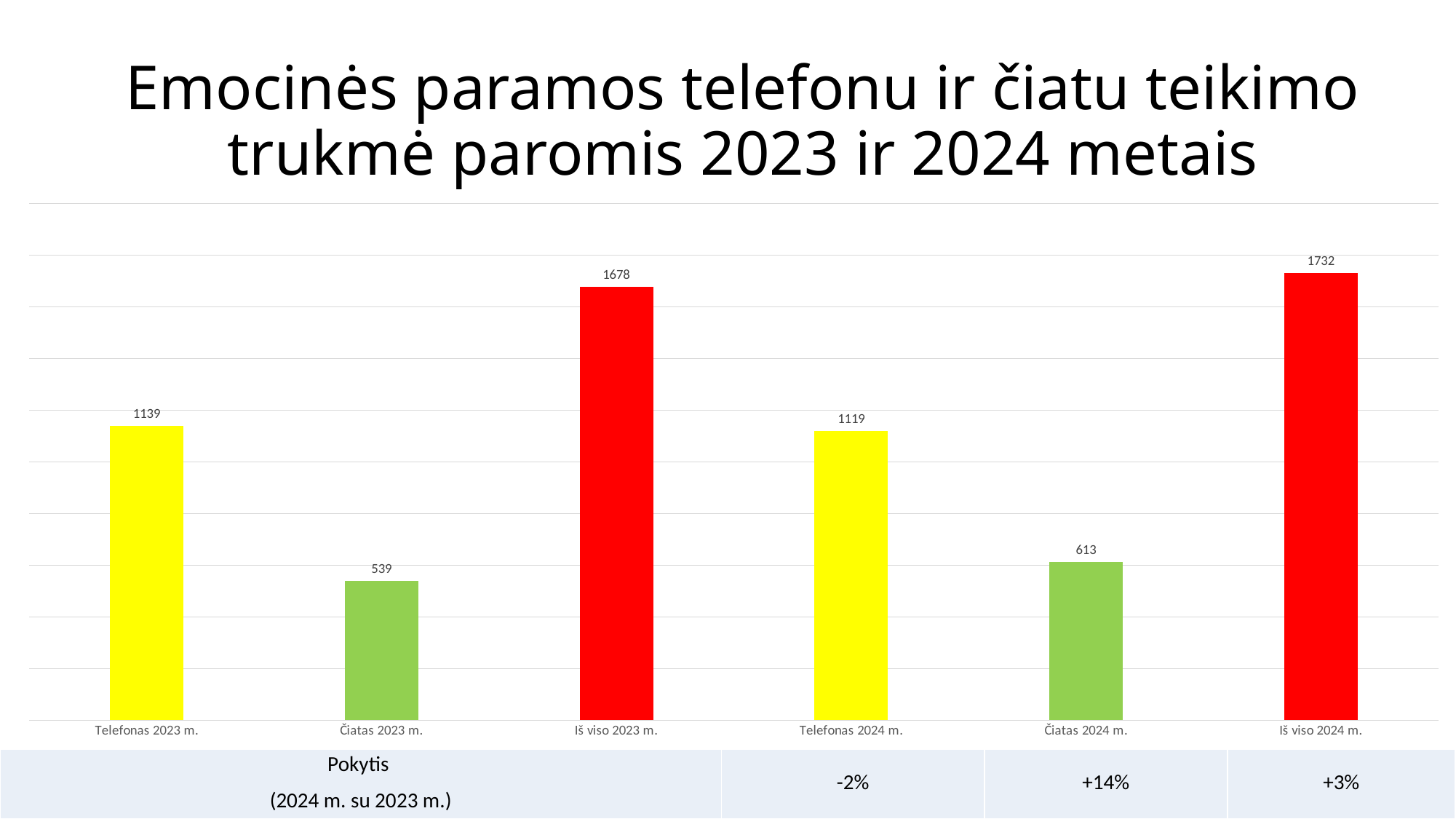
What kind of chart is shown on the slide? bar chart What is the value for Telefonas 2023 m.? 1139 What percentage change (Pokytis) is shown for Čiatas from 2023 to 2024? +14% Which category has the lowest value? Čiatas 2023 m. What is the value for Čiatas 2024 m.? 613 What colour are the Iš viso bars? red What is the difference between Čiatas 2024 m. and Čiatas 2023 m.? 74 What is the difference between Iš viso 2024 m. and Iš viso 2023 m.? 54 Which is larger, Telefonas 2023 m. or Telefonas 2024 m.? Telefonas 2023 m. Which category has the highest value? Iš viso 2024 m. How many bars are shown in the chart? 6 What is the value for Iš viso 2024 m.? 1732